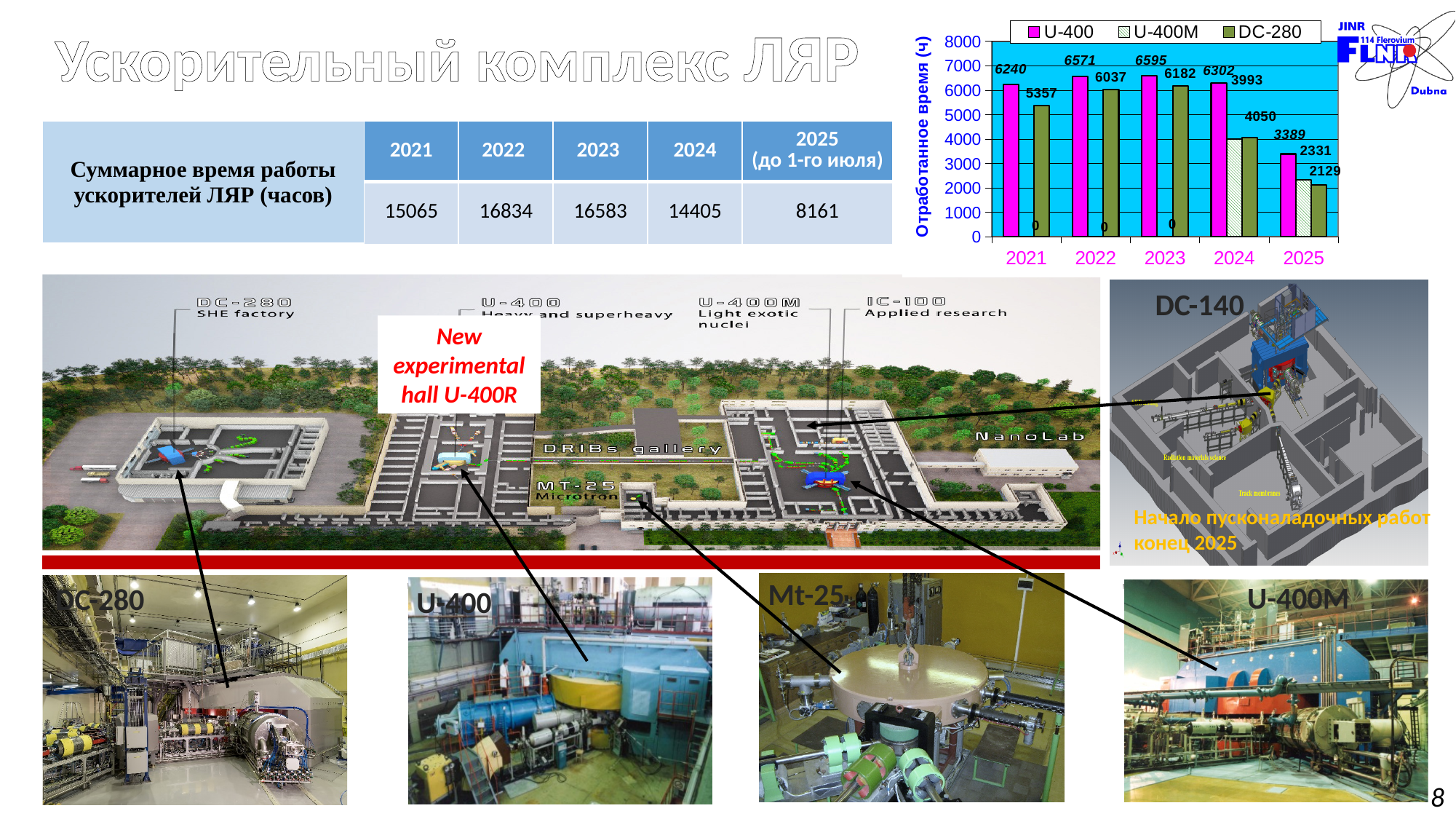
Is the value for U-400 in 2025 greater or less than 4000 in the bar chart? less What is the value for U-400 in 2023 in the bar chart? 6595 How many years are shown on the x axis of the bar chart? 5 In which year is the DC-280 value lowest in the bar chart? 2025 Which is larger in 2024 in the bar chart, U-400M or DC-280? DC-280 What is the value for U-400M in 2024 in the bar chart? 3993 How many series does the legend of the bar chart list? 3 What is the difference between the U-400 and DC-280 values in 2022 in the bar chart? 534 What type of chart is shown in the top right of the slide? bar chart What is the label of the y axis of the bar chart? Отработанное время (ч) What is the value for DC-280 in 2021 in the bar chart? 5357 In which year is the U-400 value highest in the bar chart? 2023